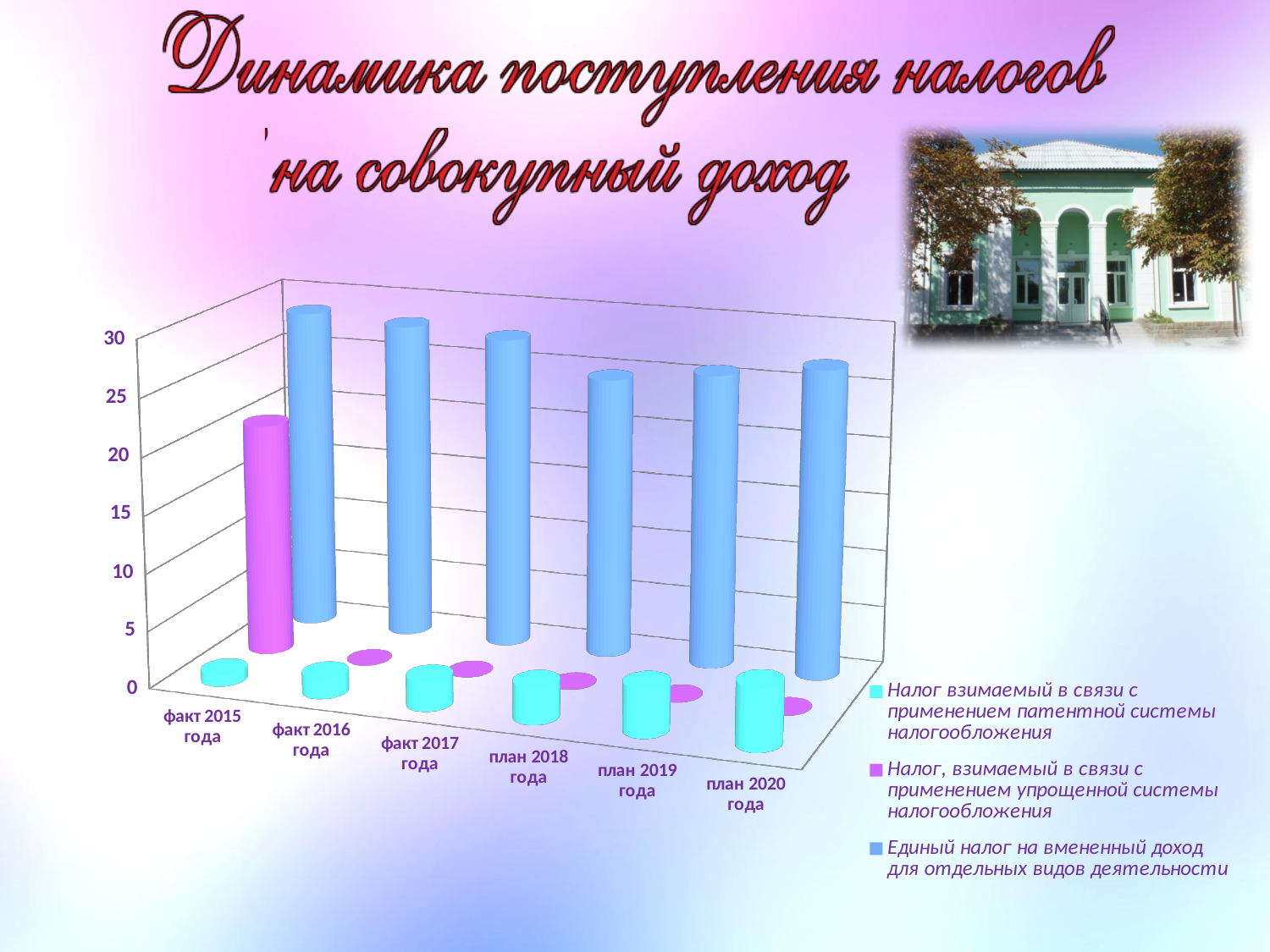
For 'Налог взимаемый в связи с применением патентной системы налогообложения', which is larger: факт 2015 года or план 2020 года? план 2020 года Is the value for 'Налог взимаемый в связи с применением патентной системы налогообложения' in факт 2015 года greater or less than 5? less Which category has the tallest bar for the series 'Единый налог на вмененный доход для отдельных видов деятельности'? факт 2015 года Do the values for 'Налог взимаемый в связи с применением патентной системы налогообложения' rise or fall from факт 2015 года to план 2020 года? rise Is the value for 'Единый налог на вмененный доход для отдельных видов деятельности' in факт 2016 года greater or less than 20? greater How many series does the chart legend list? 3 Is the value for 'Единый налог на вмененный доход для отдельных видов деятельности' in план 2018 года greater or less than 30? less In факт 2015 года, which is larger: the bar for 'Единый налог на вмененный доход для отдельных видов деятельности' or the bar for 'Налог, взимаемый в связи с применением упрощенной системы налогообложения'? Единый налог на вмененный доход для отдельных видов деятельности What kind of chart is shown on the slide? bar chart How many categories are shown along the x axis of the chart? 6 What colour represents 'Налог, взимаемый в связи с применением упрощенной системы налогообложения' in the chart? magenta (purple)